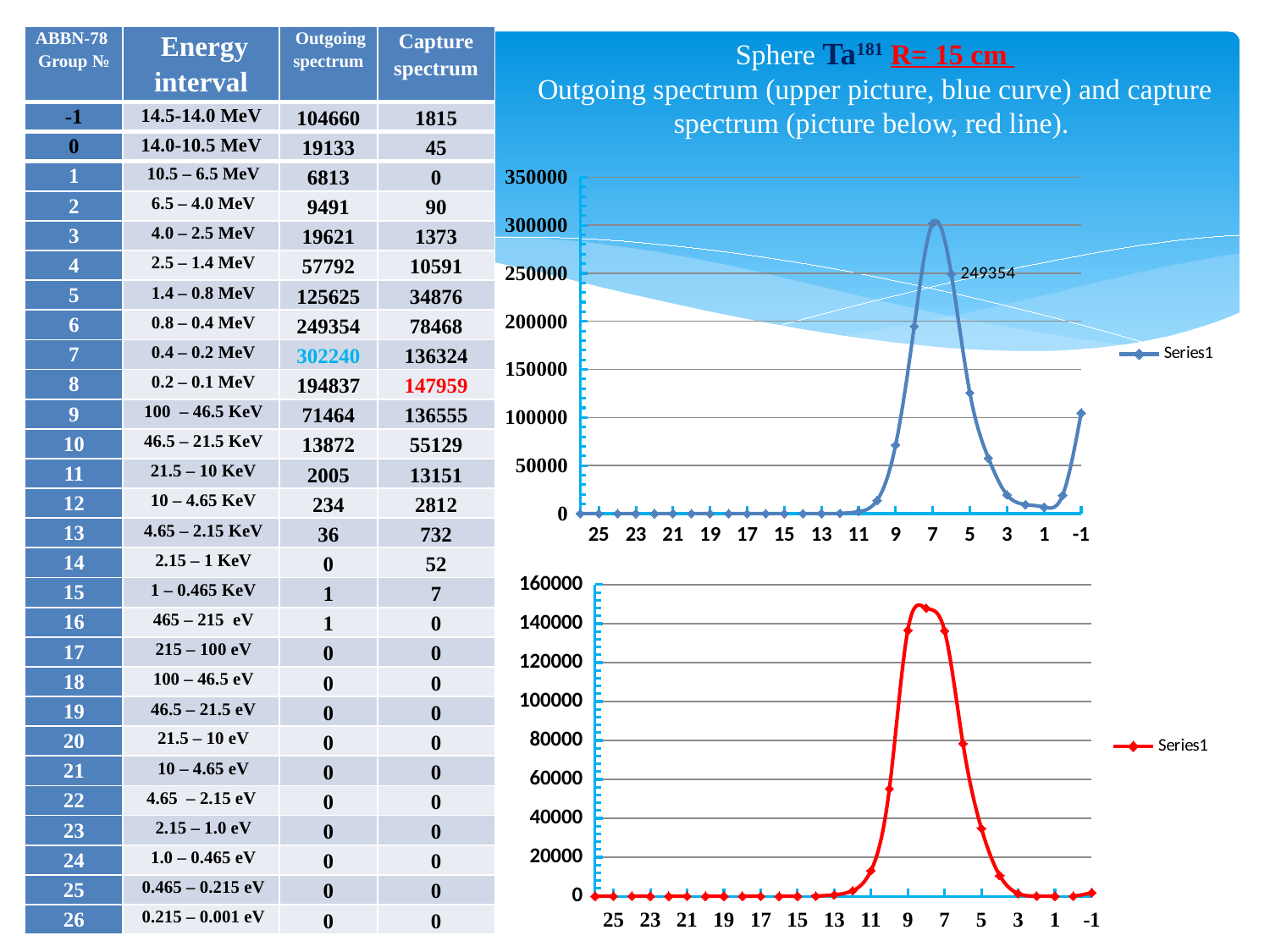
On the lower chart, which is larger: the value at x = 11 or the value at x = 3? x = 11 On the lower chart, is the highest value greater or less than 140000? greater On the upper chart, which is larger: the value at x = 9 or the value at x = 5? x = 5 On the upper chart, what value is shown by the data label next to the curve? 249354 What kind of chart is the lower chart (red curve)? line chart How many series does the legend of the lower chart list? 1 On the lower chart, is the value at x = 11 greater or less than 20000? less On the upper chart, is the value at x = 9 greater or less than 100000? less On the upper chart, at which x-axis category does the curve reach its highest value? 7 What kind of chart is the upper chart (blue curve)? line chart On the upper chart, do the values rise or fall going from x = 7 to x = 1? fall